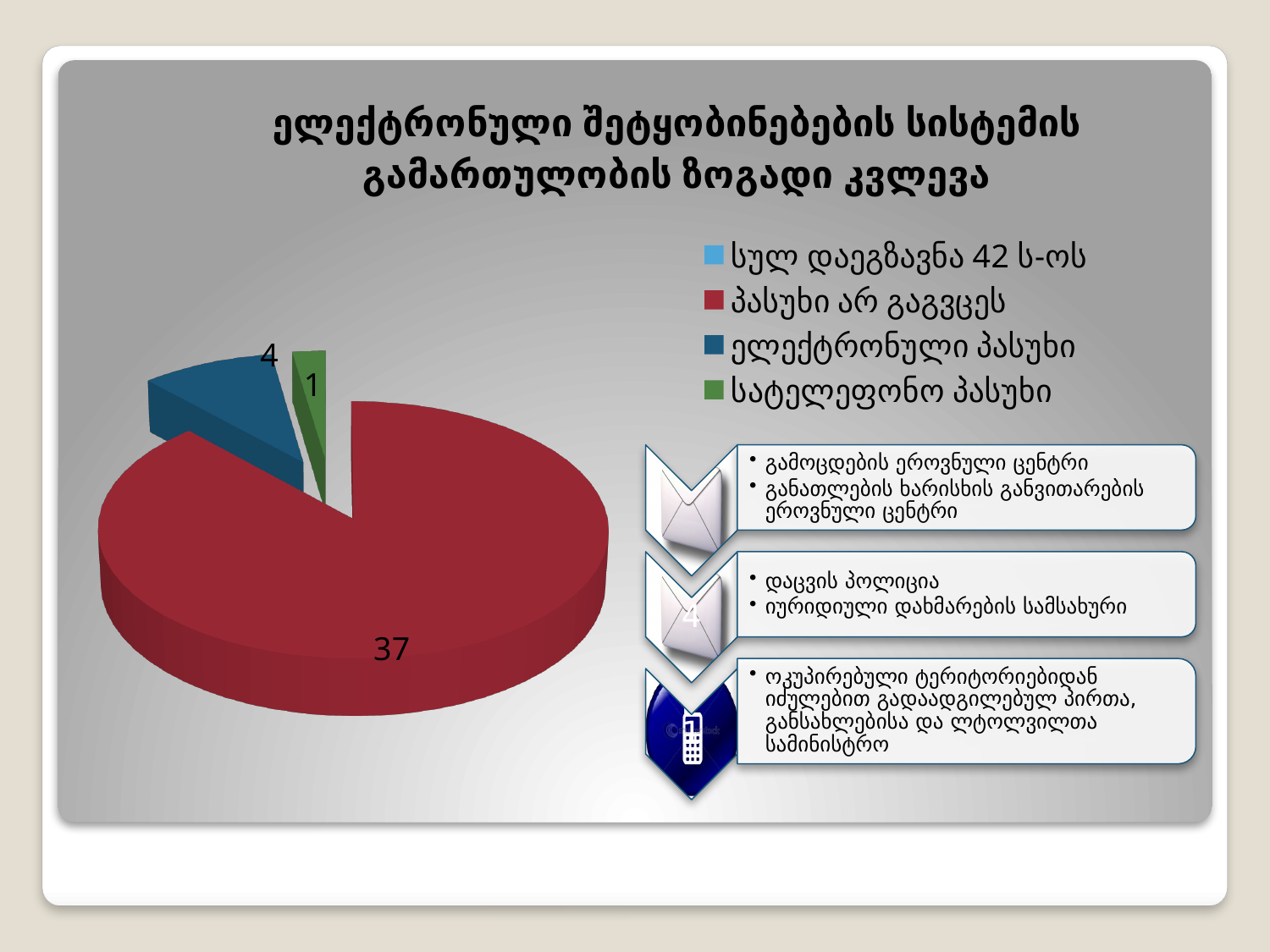
What type of chart is shown on the slide? Pie chart What colour is the slice for ელექტრონული პასუხი? Blue What value is shown for the blue slice (ელექტრონული პასუხი) in the pie chart? 4 How many slices are visible in the pie chart? 3 What value is shown for the green slice (სატელეფონო პასუხი) in the pie chart? 1 What is the total of the values labelled on the pie chart slices? 42 What is the difference between the values for პასუხი არ გაგვცეს and ელექტრონული პასუხი? 33 What value is shown for the red slice (პასუხი არ გაგვცეს) in the pie chart? 37 Which category has the largest slice in the pie chart? პასუხი არ გაგვცეს Which category has the smallest slice in the pie chart? სატელეფონო პასუხი How many entries does the chart legend list? 4 Which is larger: the value for ელექტრონული პასუხი or for სატელეფონო პასუხი? ელექტრონული პასუხი